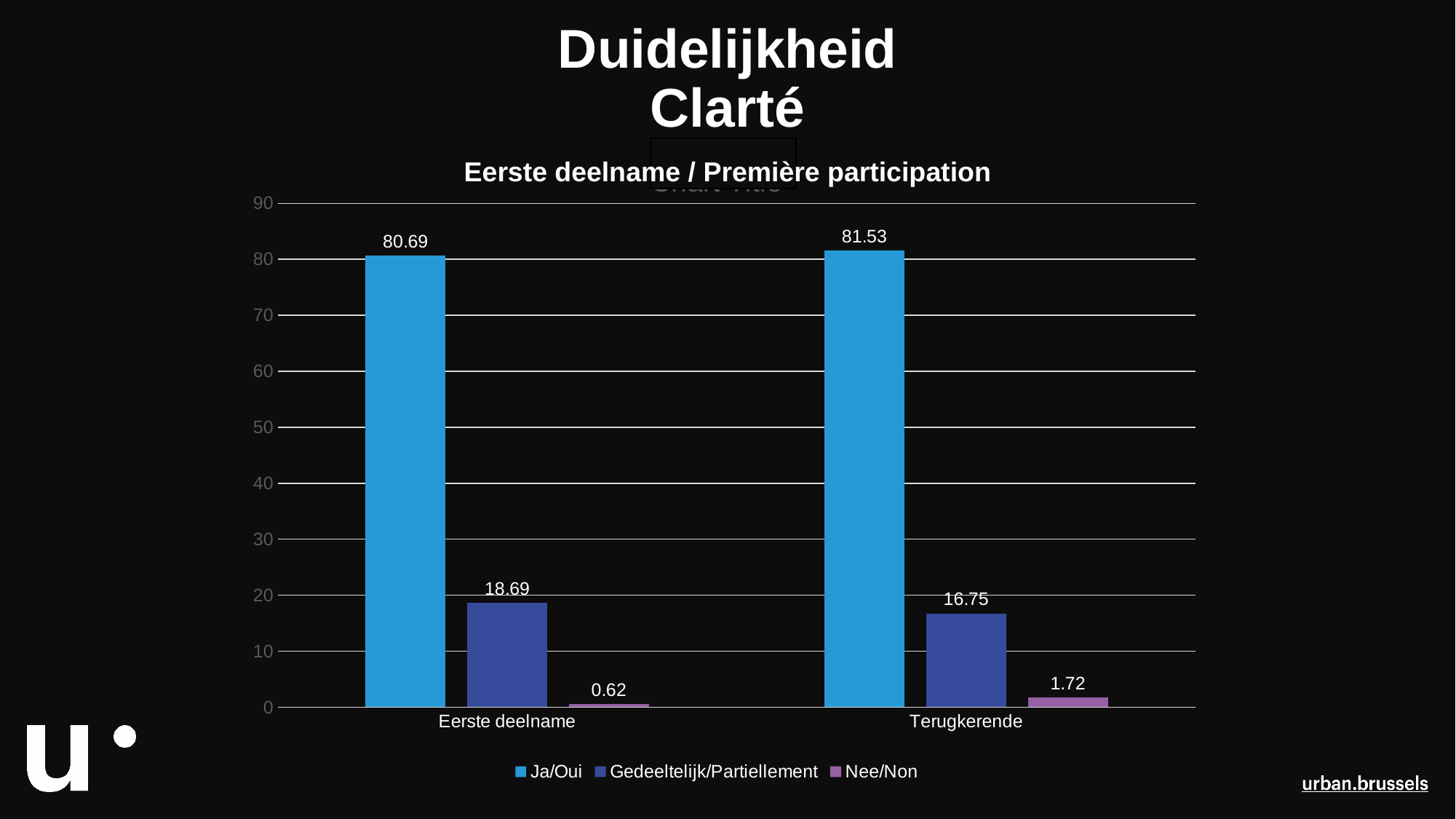
How many series does the legend list? 3 Which series has the highest value in the Terugkerende category? Ja/Oui What is the value for Ja/Oui in the Eerste deelname category? 80.69 What kind of chart is shown on the slide? Bar chart How many categories are shown on the x axis? 2 What is the value for Nee/Non in the Eerste deelname category? 0.62 What is the value for Nee/Non in the Terugkerende category? 1.72 What is the value for Gedeeltelijk/Partiellement in the Terugkerende category? 16.75 Which is larger: Gedeeltelijk/Partiellement for Eerste deelname or for Terugkerende? Eerste deelname What colour are the Ja/Oui bars? Light blue What is the difference between the Ja/Oui values for Terugkerende and Eerste deelname? 0.84 Which series has the lowest value in the Eerste deelname category? Nee/Non